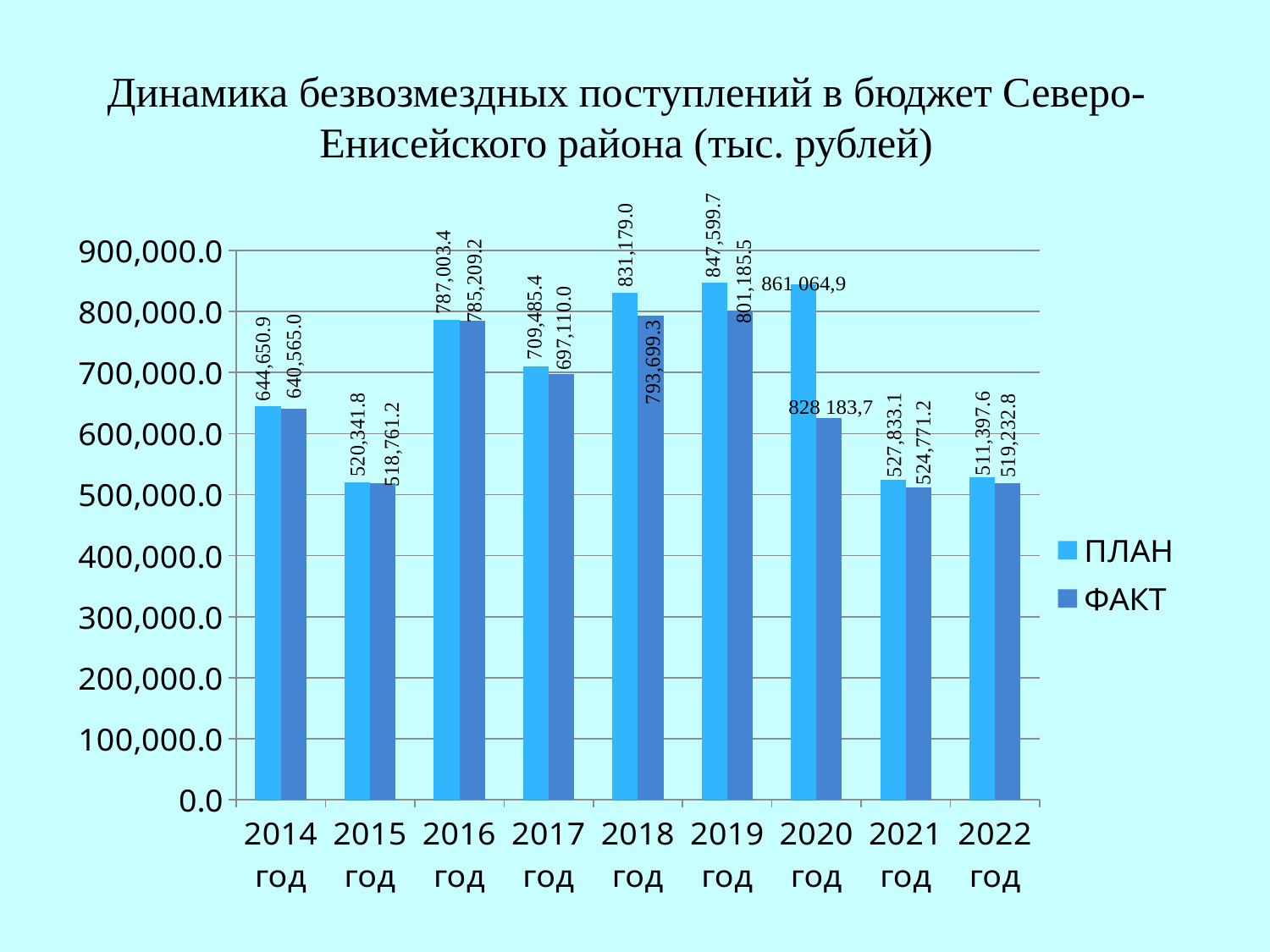
How many series does the legend list? 2 What kind of chart is shown on the slide? bar chart What is the difference between the ПЛАН and ФАКТ values for 2019 год? 46,414.2 Is the ПЛАН value for 2018 год greater or less than 800,000.0? greater How many years are shown on the x axis? 9 What is the ФАКТ value for 2017 год? 697,110.0 What is the ПЛАН value for 2019 год? 847,599.7 Do the ПЛАН values rise or fall from 2020 год to 2022 год? fall What is the ФАКТ value for 2014 год? 640,565.0